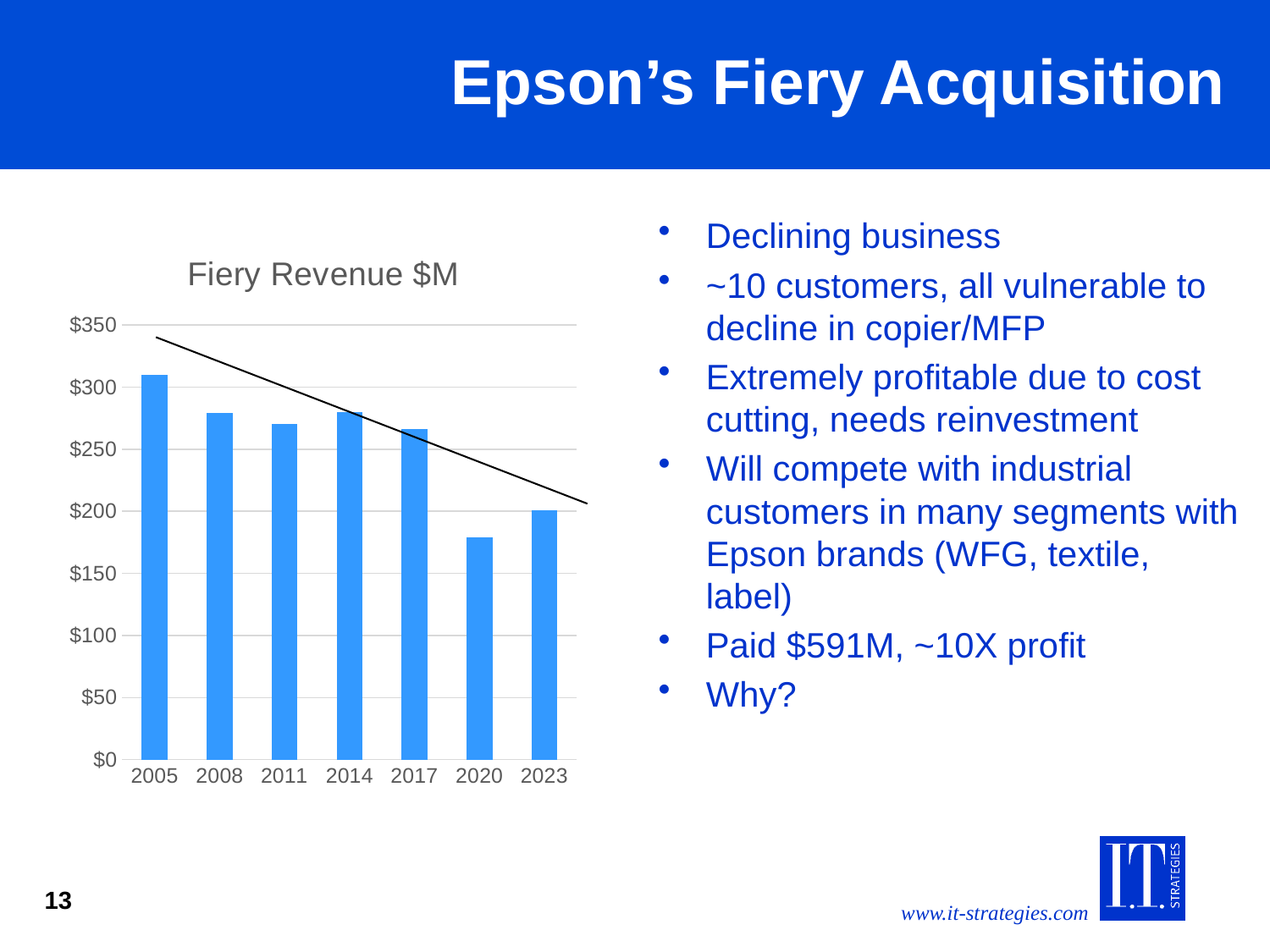
What is the title of the chart? Fiery Revenue $M Is the Fiery revenue for 2005 greater or less than $300? greater Which year has the lowest Fiery revenue? 2020 Is the Fiery revenue for 2023 greater or less than $250? less Which year has higher Fiery revenue, 2005 or 2020? 2005 Overall, does Fiery revenue rise or fall from 2005 to 2023? Fall What kind of chart is shown on the slide? Bar chart Which year has the highest Fiery revenue? 2005 Is the Fiery revenue for 2020 greater or less than $200? less How many years are plotted on the x axis of the chart? 7 Which year has higher Fiery revenue, 2020 or 2023? 2023